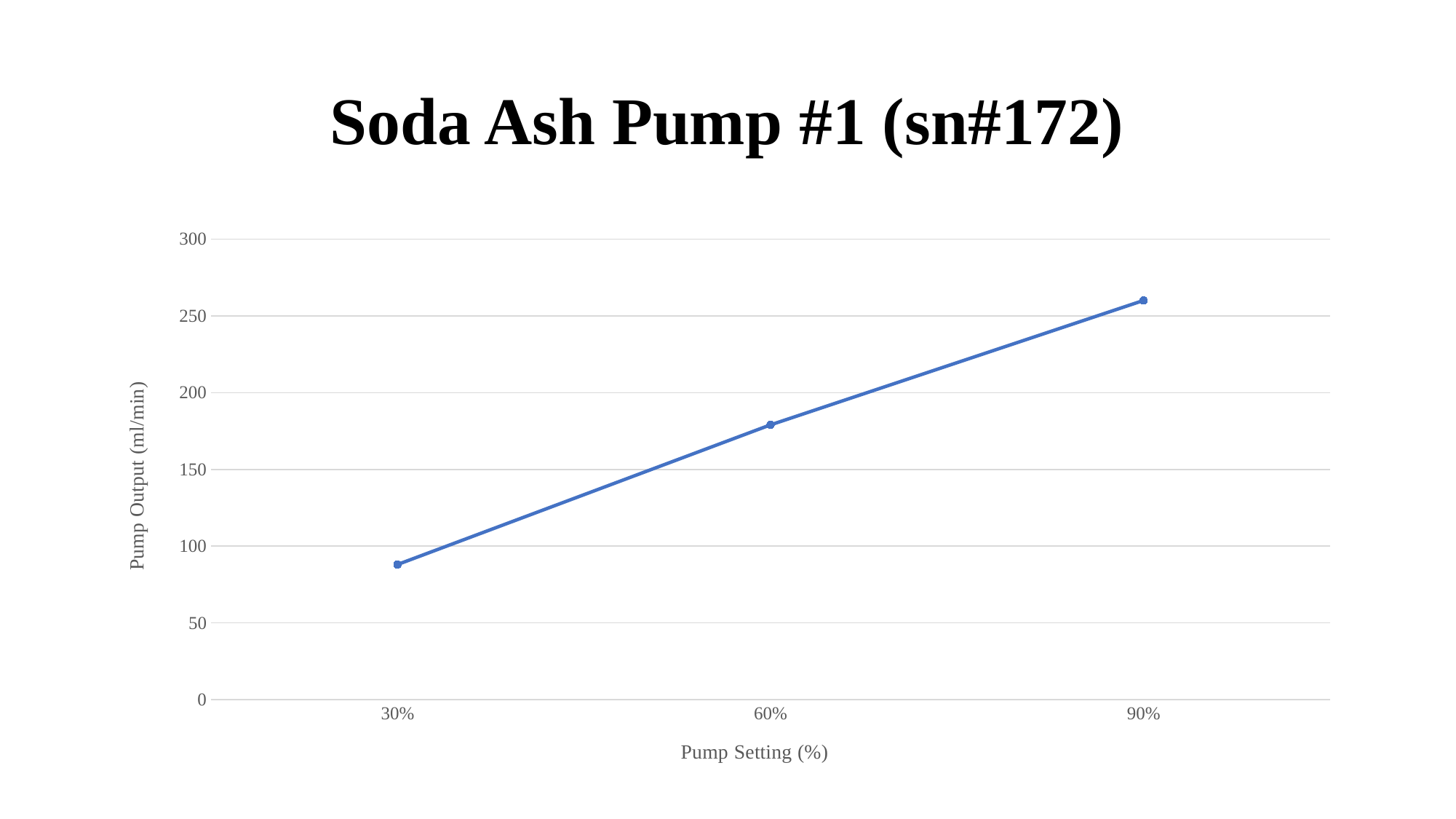
Which has the larger pump output, the 30% setting or the 60% setting? 60% What kind of chart is shown on the slide? line chart Which pump setting has the lowest pump output? 30% How many pump settings are plotted on the chart? 3 What is the title of the chart? Soda Ash Pump #1 (sn#172) Which pump setting has the highest pump output? 90% Is the pump output at the 30% setting greater or less than 100? less Is the pump output at the 60% setting greater or less than 150? greater Is the pump output at the 90% setting greater or less than 200? greater Does the pump output rise or fall as the pump setting increases from 30% to 90%? rise What is the label of the vertical axis? Pump Output (ml/min)